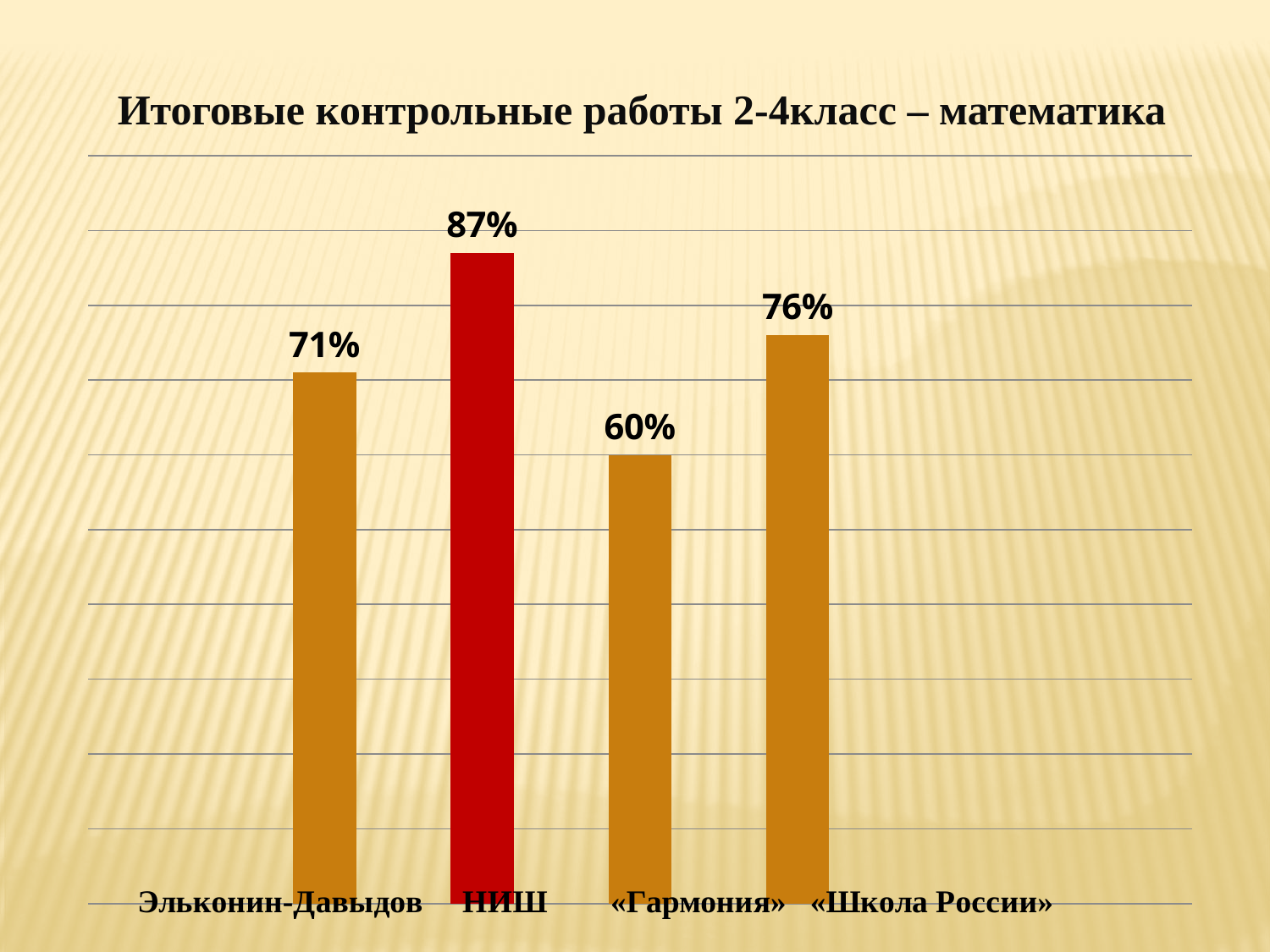
Which is larger, the value for Эльконин-Давыдов or the value for «Школа России»? «Школа России» What is the value for НИШ? 87% What is the difference between the values for «Школа России» and Эльконин-Давыдов? 5% What is the value for «Школа России»? 76% How many categories are shown in the chart? 4 What is the value for Эльконин-Давыдов? 71% Which category has the highest value? НИШ What is the difference between the values for НИШ and «Гармония»? 27% Which bar is coloured red, unlike the others? НИШ What is the value for «Гармония»? 60% Which category has the lowest value? «Гармония» What kind of chart is shown on the slide? Bar chart